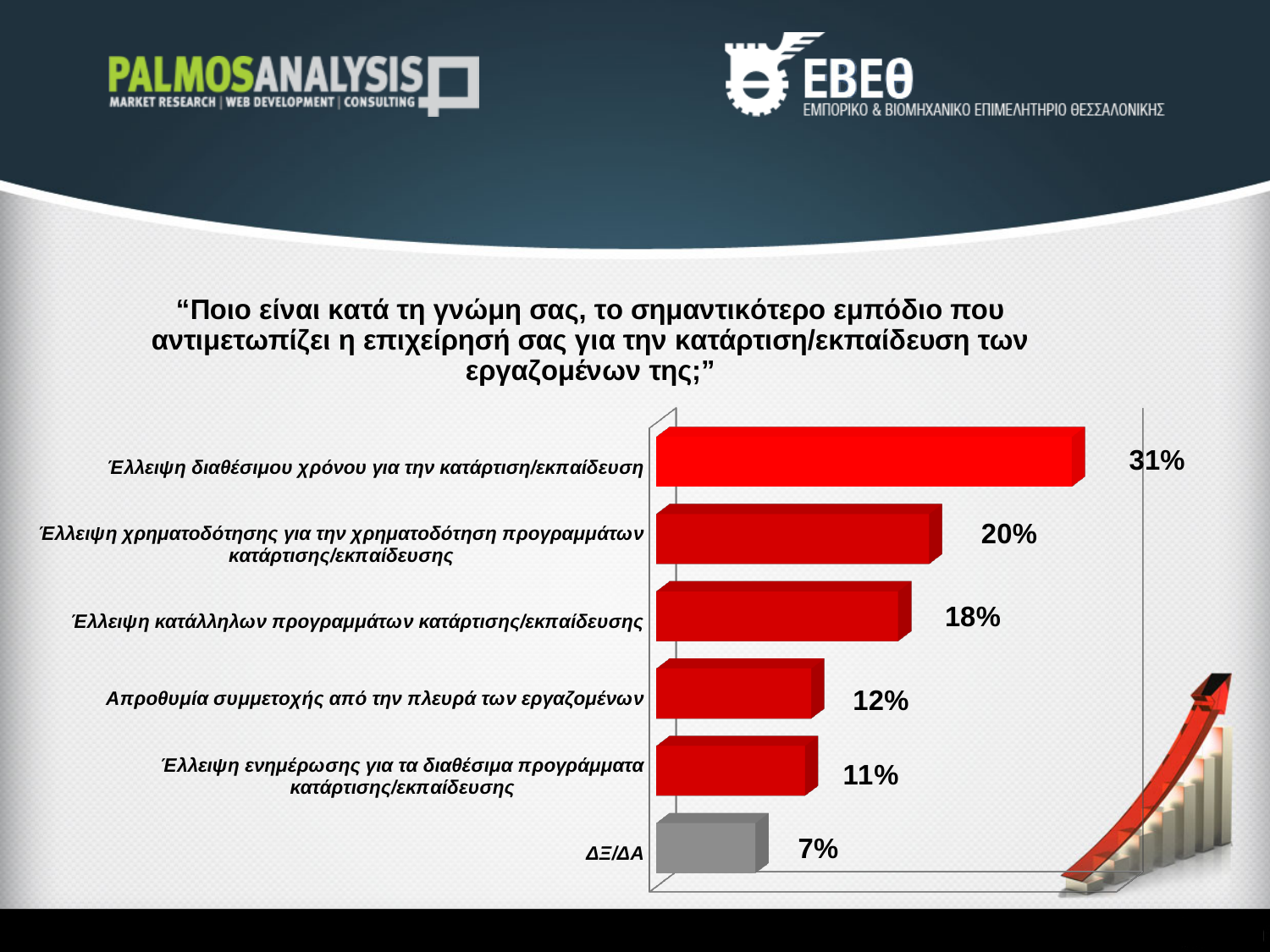
How many categories are shown in the chart? 6 What percentage is shown for "Έλλειψη διαθέσιμου χρόνου για την κατάρτιση/εκπαίδευση"? 31% What is the difference between the values for "Έλλειψη διαθέσιμου χρόνου για την κατάρτιση/εκπαίδευση" and "Έλλειψη χρηματοδότησης για την χρηματοδότηση προγραμμάτων κατάρτισης/εκπαίδευσης"? 11% What is the difference between the values for "Έλλειψη κατάλληλων προγραμμάτων κατάρτισης/εκπαίδευσης" and "Έλλειψη ενημέρωσης για τα διαθέσιμα προγράμματα κατάρτισης/εκπαίδευσης"? 7% What value is shown for "ΔΞ/ΔΑ"? 7% What percentage is shown for "Απροθυμία συμμετοχής από την πλευρά των εργαζομένων"? 12% Which category has the highest value? Έλλειψη διαθέσιμου χρόνου για την κατάρτιση/εκπαίδευση Which is larger: the value for "Έλλειψη κατάλληλων προγραμμάτων κατάρτισης/εκπαίδευσης" or the value for "Απροθυμία συμμετοχής από την πλευρά των εργαζομένων"? Έλλειψη κατάλληλων προγραμμάτων κατάρτισης/εκπαίδευσης What kind of chart is shown on the slide? Bar chart Which category has the lowest value? ΔΞ/ΔΑ What value is shown for "Έλλειψη χρηματοδότησης για την χρηματοδότηση προγραμμάτων κατάρτισης/εκπαίδευσης"? 20% What colour is the bar for "ΔΞ/ΔΑ"? Grey